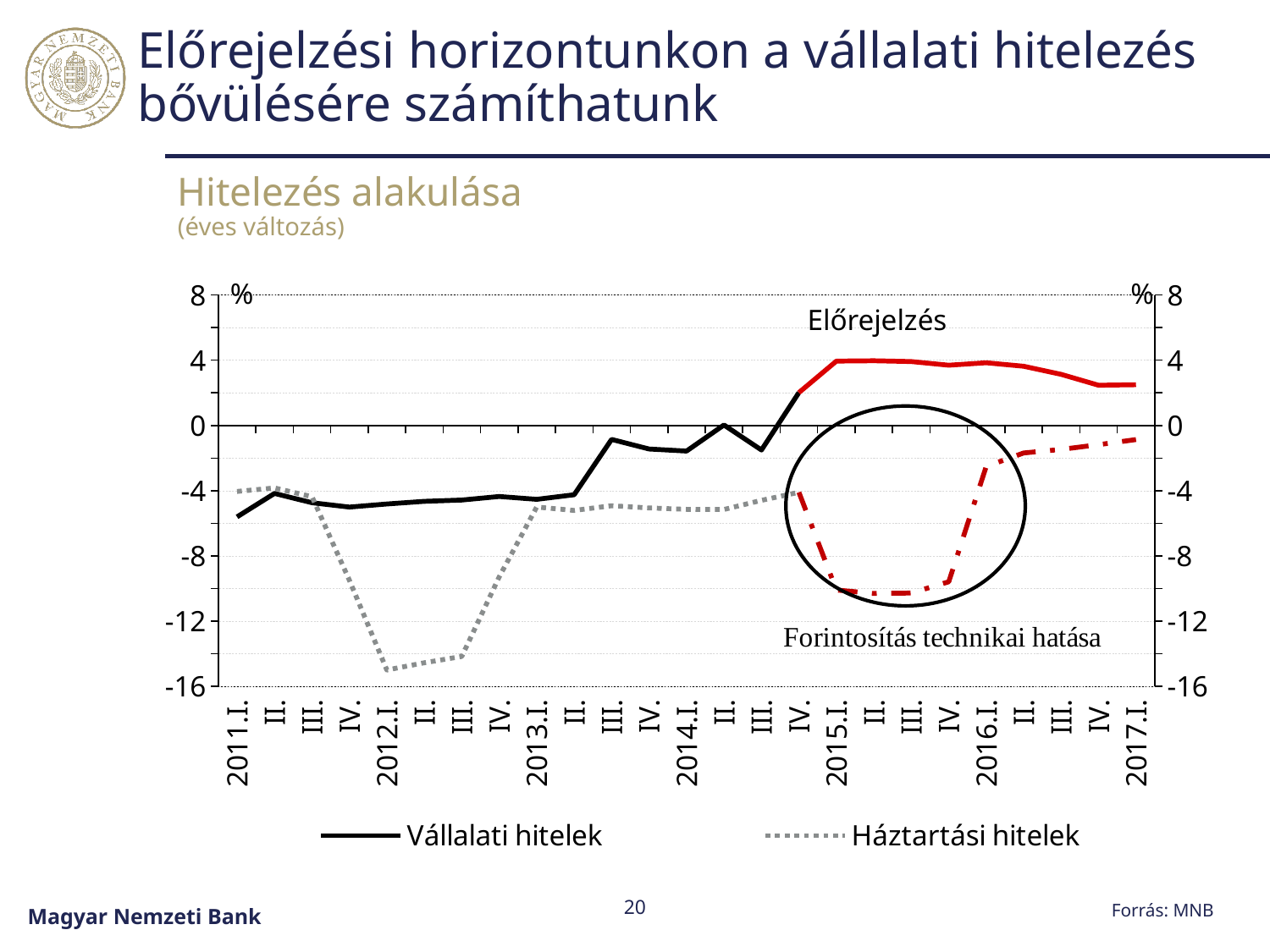
At 2012.I, which series has the higher value, Vállalati hitelek or Háztartási hitelek? Vállalati hitelek Is the value for Háztartási hitelek at 2015.III greater or less than -8? less Is the value for Vállalati hitelek at 2015.I greater or less than 0? greater Is the value for Vállalati hitelek at 2011.I greater or less than -4? less What kind of chart is shown on the slide? line chart What is the title of the chart? Hitelezés alakulása (éves változás) What are the two series named in the legend? Vállalati hitelek and Háztartási hitelek Does the Vállalati hitelek line rise or fall between 2014.III and 2015.I? rise Does the Háztartási hitelek line rise or fall between 2012.III and 2013.I? rise How many quarterly labels are shown on the x axis? 25 How many series does the legend list? 2